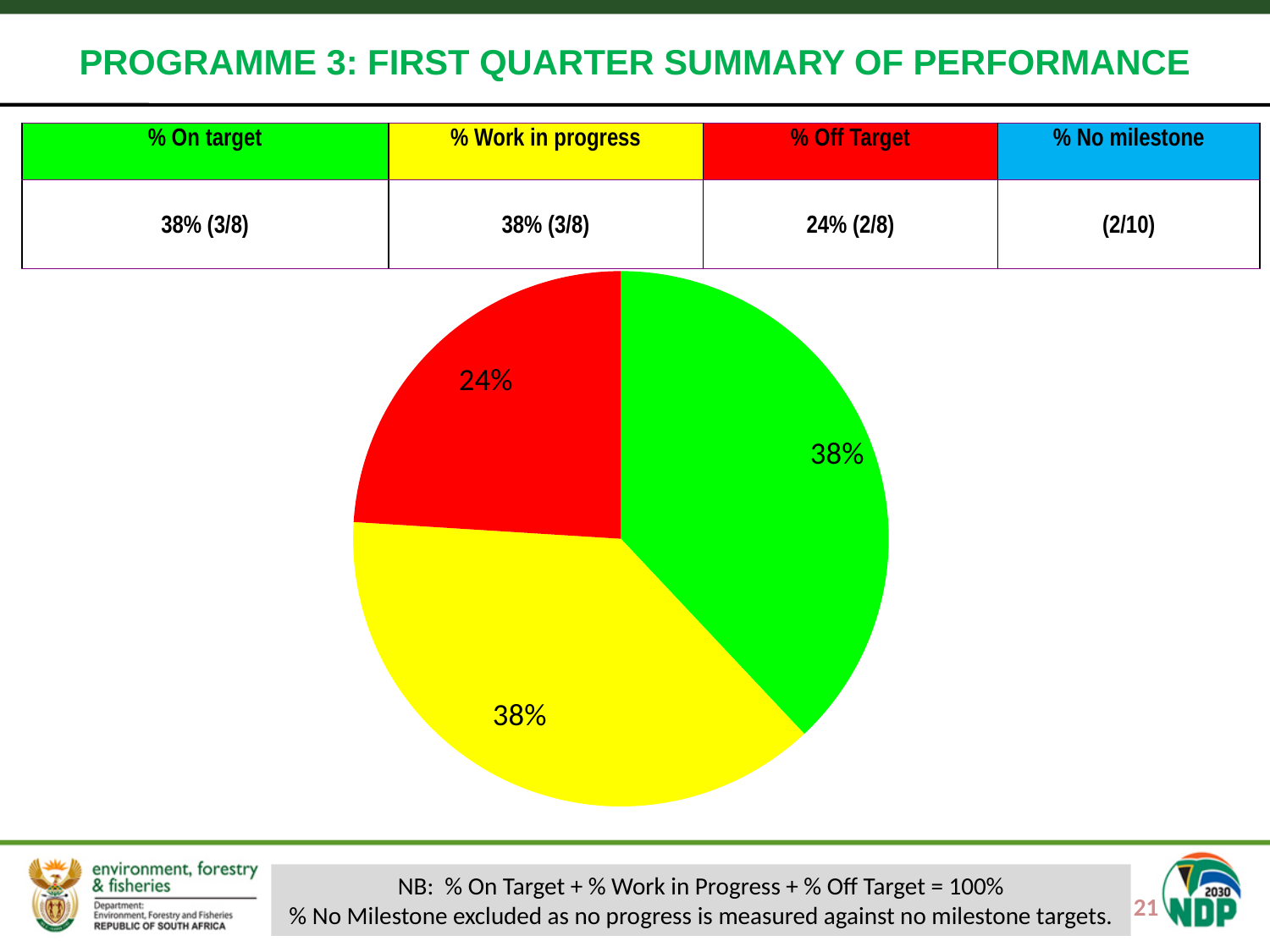
How many slices does the pie chart have? 3 Which colour slice of the pie chart is the smallest? red What is the title of the slide containing the pie chart? PROGRAMME 3: FIRST QUARTER SUMMARY OF PERFORMANCE What is the combined share of the two 38% slices in the pie chart? 76% What kind of chart is shown on the slide? pie chart What percentage is shown on the red slice of the pie chart? 24% What is the share of the pie chart taken by the Off Target slice? 24% Is the red slice of the pie chart larger or smaller than the yellow slice? smaller According to the table above the pie chart, which category does the red colour represent? % Off Target What percentage is shown on the green slice of the pie chart? 38% What is the difference between the green slice's percentage and the red slice's percentage? 14% What percentage is shown on the yellow slice of the pie chart? 38%